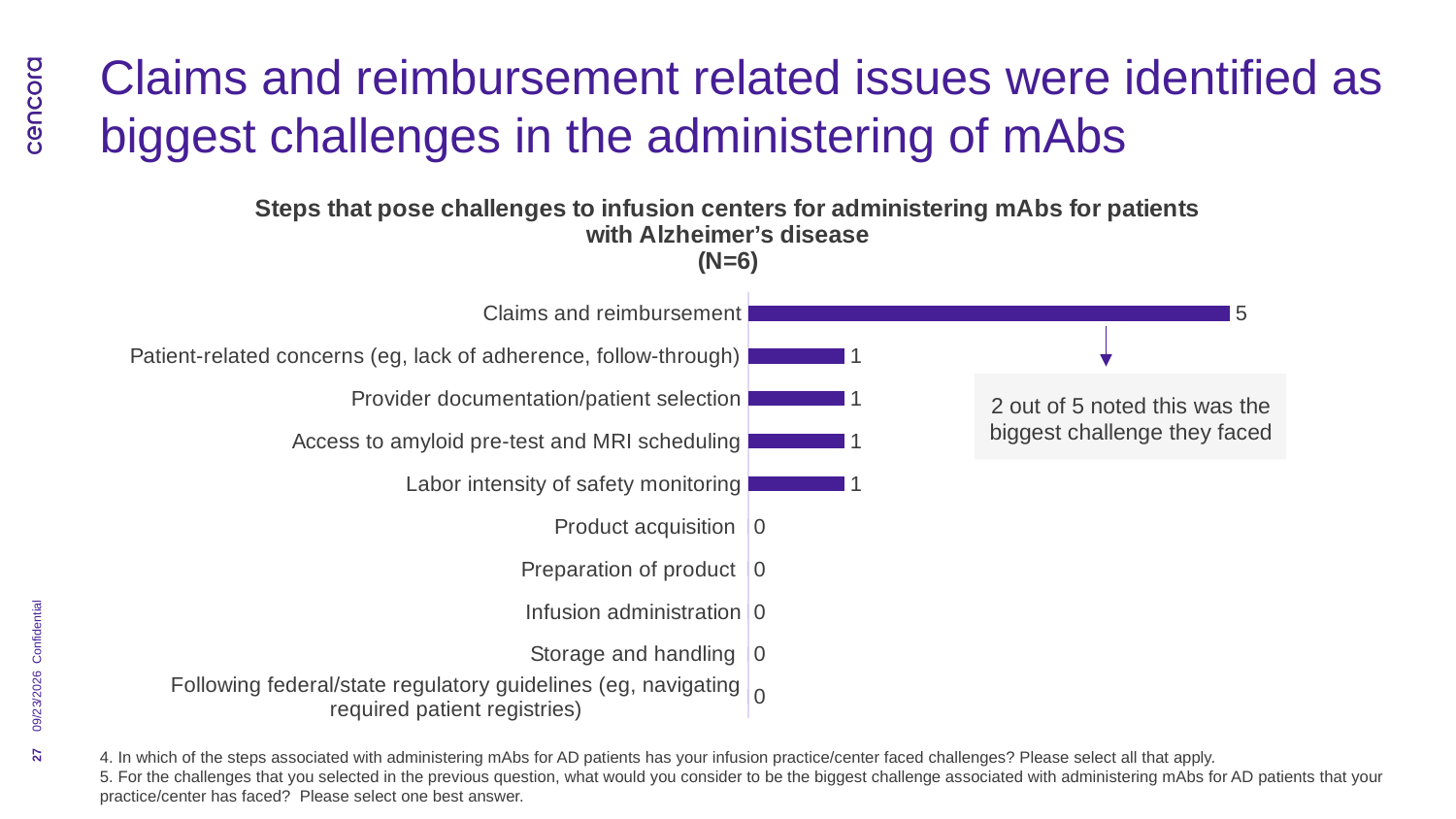
What kind of chart is shown on the slide? Bar chart What is the sample size (N) stated in the chart title? N=6 Which is larger, the value for Access to amyloid pre-test and MRI scheduling or the value for Storage and handling? Access to amyloid pre-test and MRI scheduling What is the value for Product acquisition? 0 According to the callout on the chart, how many out of 5 noted Claims and reimbursement was the biggest challenge they faced? 2 out of 5 How many categories are shown in the chart? 10 Which category has the highest value? Claims and reimbursement How many categories have a value of 0? 5 What is the value for Labor intensity of safety monitoring? 1 How many categories have a value of 1? 4 What is the difference between the values for Claims and reimbursement and Provider documentation/patient selection? 4 What is the value for Claims and reimbursement? 5